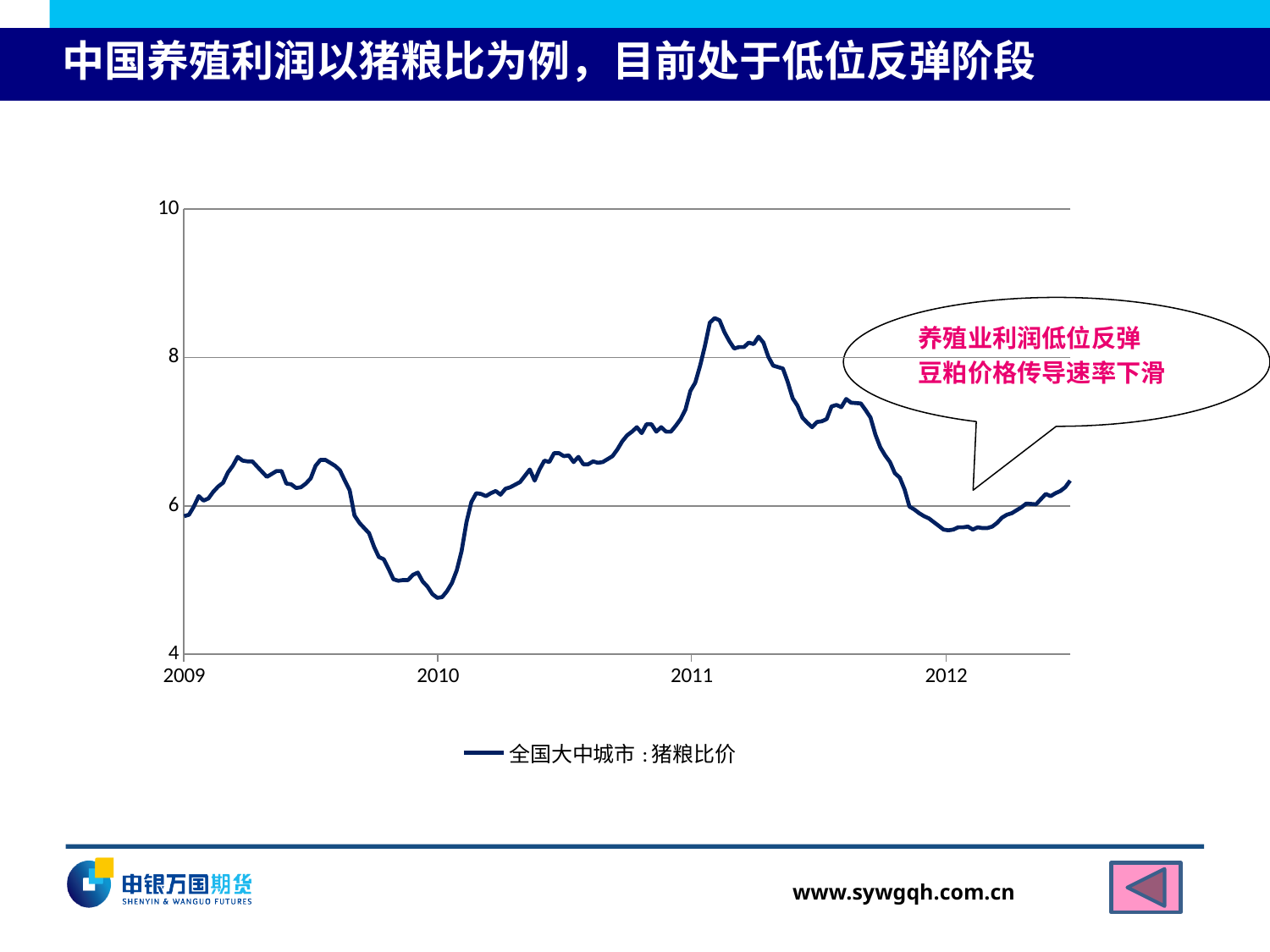
How many series does the legend list? 1 Does the 猪粮比价 line rise or fall between the start of 2010 and the start of 2011? rise How many year labels are shown on the x axis? 4 Is the peak value of 猪粮比价 reached in 2011 greater or less than 8? greater What is the legend entry for the plotted series? 全国大中城市：猪粮比价 Does the 猪粮比价 line rise or fall from its 2011 peak to the start of 2012? fall Is the value of 猪粮比价 at the start of 2011 greater or less than 6? greater Is the value of 猪粮比价 at the start of 2012 greater or less than 6? less What kind of chart is shown on the slide? line chart In which year does the 猪粮比价 line reach its highest point? 2011 What text appears in the callout bubble on the chart? 养殖业利润低位反弹 豆粕价格传导速率下滑